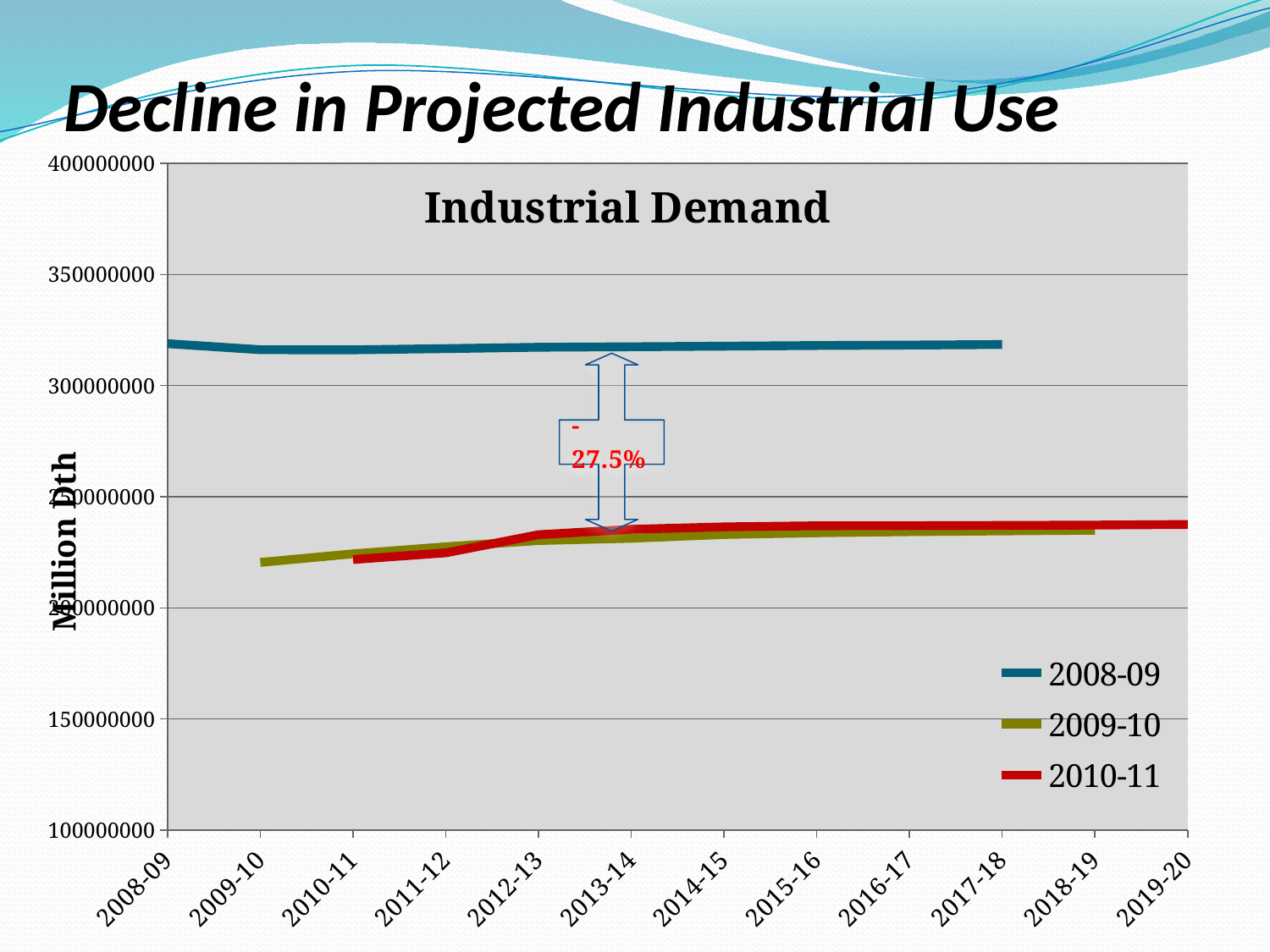
What kind of chart is shown on the slide? line chart How many series does the legend list? 3 What is the title of the chart? Industrial Demand Does the 2010-11 series rise or fall from 2010-11 to 2019-20? rise Is the value of the 2008-09 series at 2008-09 greater or less than 300000000? greater Is the value of the 2010-11 series at 2019-20 greater or less than 200000000? greater Which series has the highest values across the chart? 2008-09 What is the label on the vertical axis? Million Dth Is the value of the 2008-09 series at 2017-18 greater or less than 350000000? less At 2013-14, which series has the larger value, 2008-09 or 2010-11? 2008-09 How many categories are shown along the x axis? 12